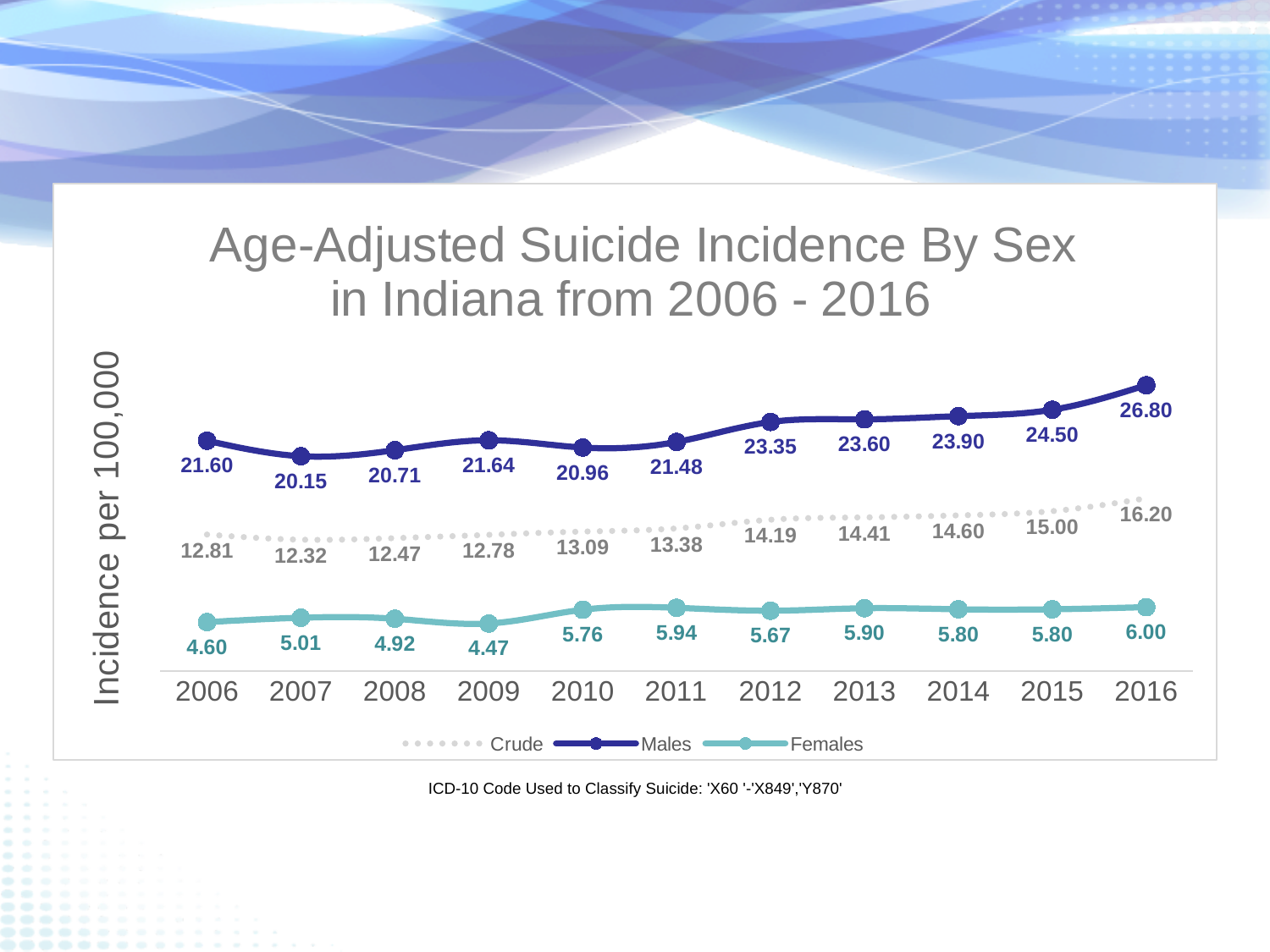
Which is larger, the Females value in 2011 or the Females value in 2012? 2011 What kind of chart is shown? line chart What is the Crude value for 2012? 14.19 In which year is the Crude series highest? 2016 What is the y-axis label of the chart? Incidence per 100,000 What is the Females value for 2009? 4.47 How many series does the legend list? 3 In which year is the Males series lowest? 2007 How many years are shown on the x axis? 11 Does the Crude series generally rise or fall from 2007 to 2016? rise What is the difference between the Males and Females values in 2016? 20.80 What is the Males value for 2016? 26.80